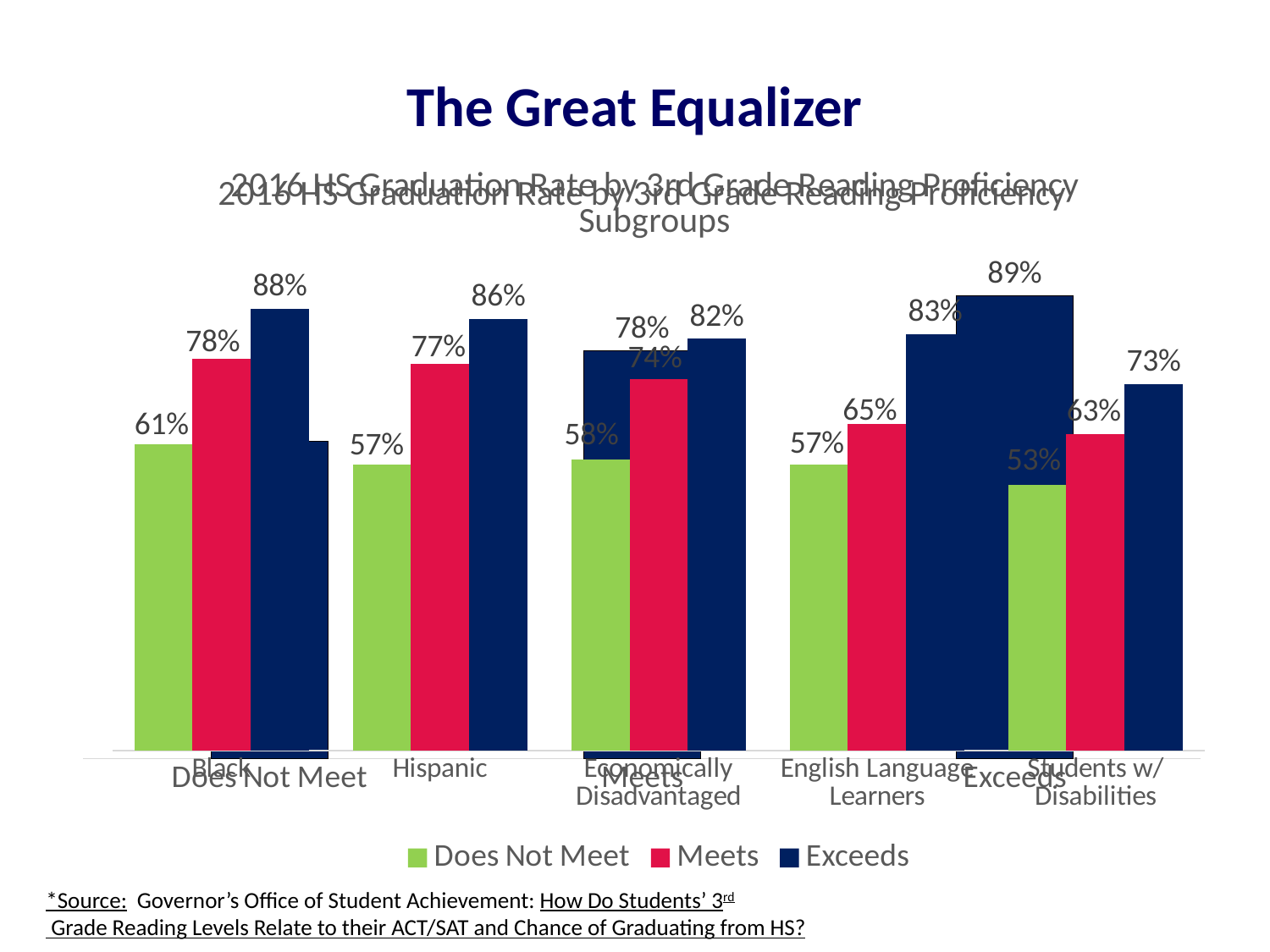
In the chart titled '2016 HS Graduation Rate by 3rd Grade Reading Proficiency Subgroups', which subgroup has the lowest Meets value? Students w/ Disabilities In the chart titled '2016 HS Graduation Rate by 3rd Grade Reading Proficiency Subgroups', which is larger: the Meets value for Hispanic students or the Meets value for English Language Learners? Hispanic In the chart titled '2016 HS Graduation Rate by 3rd Grade Reading Proficiency Subgroups', what is the difference between the Exceeds and Meets values for English Language Learners? 18% In the chart titled '2016 HS Graduation Rate by 3rd Grade Reading Proficiency Subgroups', what is the difference between the Exceeds and Does Not Meet values for Black students? 27% What kind of chart is the '2016 HS Graduation Rate by 3rd Grade Reading Proficiency Subgroups' chart? Bar chart In the chart titled '2016 HS Graduation Rate by 3rd Grade Reading Proficiency Subgroups', what is the Exceeds value for Students w/ Disabilities? 73% How many subgroups are shown on the x axis of the chart titled '2016 HS Graduation Rate by 3rd Grade Reading Proficiency Subgroups'? 5 In the chart titled '2016 HS Graduation Rate by 3rd Grade Reading Proficiency Subgroups', what is the Meets value for English Language Learners? 65% In the chart titled '2016 HS Graduation Rate by 3rd Grade Reading Proficiency Subgroups', what is the Does Not Meet value for Hispanic students? 57% In the chart titled '2016 HS Graduation Rate by 3rd Grade Reading Proficiency Subgroups', what is the Exceeds value for Black students? 88% How many series does the legend list for the chart titled '2016 HS Graduation Rate by 3rd Grade Reading Proficiency Subgroups'? 3 In the chart titled '2016 HS Graduation Rate by 3rd Grade Reading Proficiency Subgroups', which subgroup has the highest Exceeds value? Black